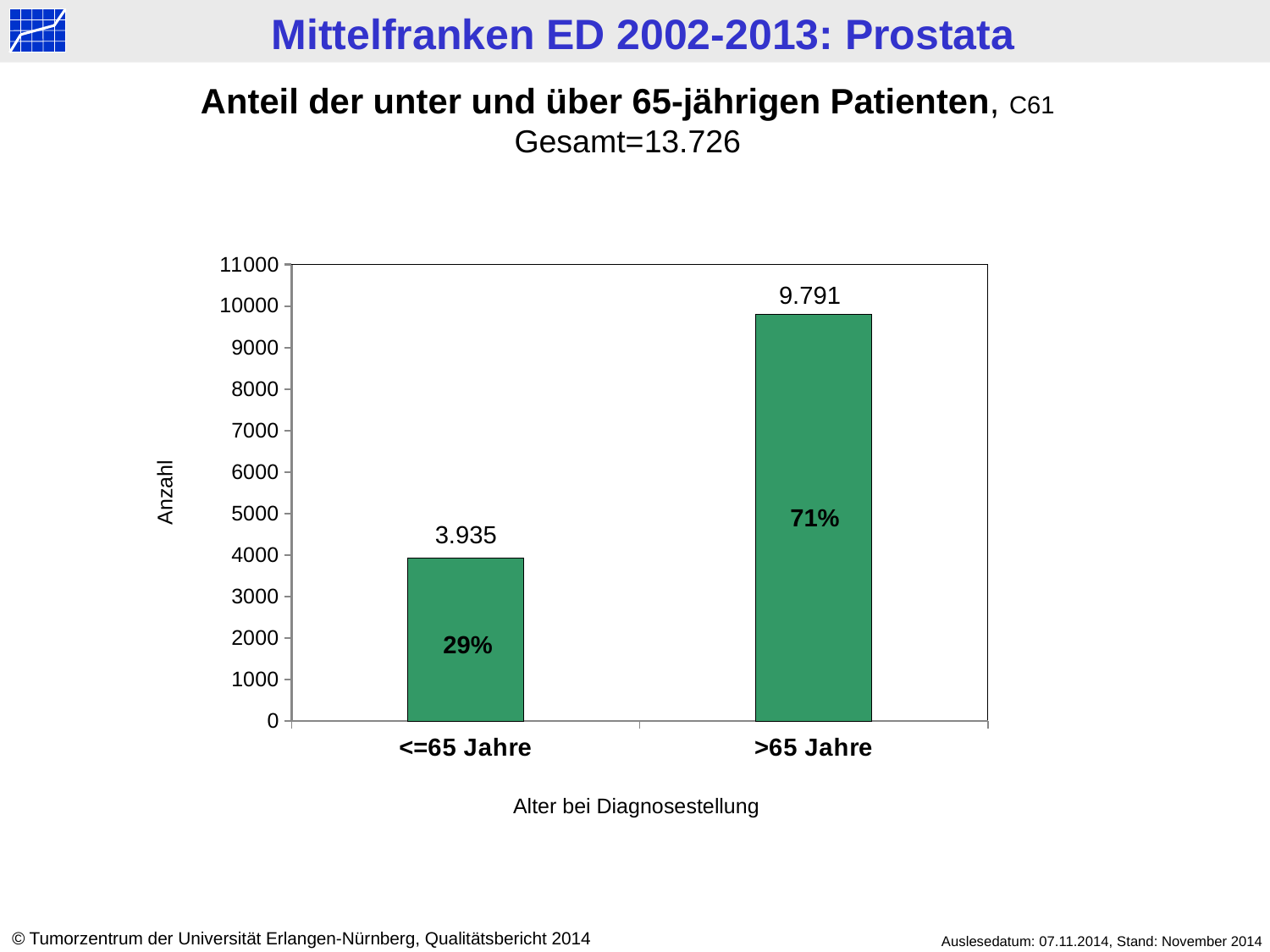
Is the value for >65 Jahre greater or less than 9000? greater What is the difference between the values for >65 Jahre and <=65 Jahre? 5.856 What percentage is shown inside the <=65 Jahre bar? 29% Which is larger, the value for <=65 Jahre or for >65 Jahre? >65 Jahre How many categories are shown on the x axis? 2 What is the value for the <=65 Jahre category? 3.935 Which category has the lowest value? <=65 Jahre What is the value for the >65 Jahre category? 9.791 Which category has the highest value? >65 Jahre What is the label of the x axis? Alter bei Diagnosestellung What kind of chart is shown on the slide? bar chart What percentage is shown inside the >65 Jahre bar? 71%